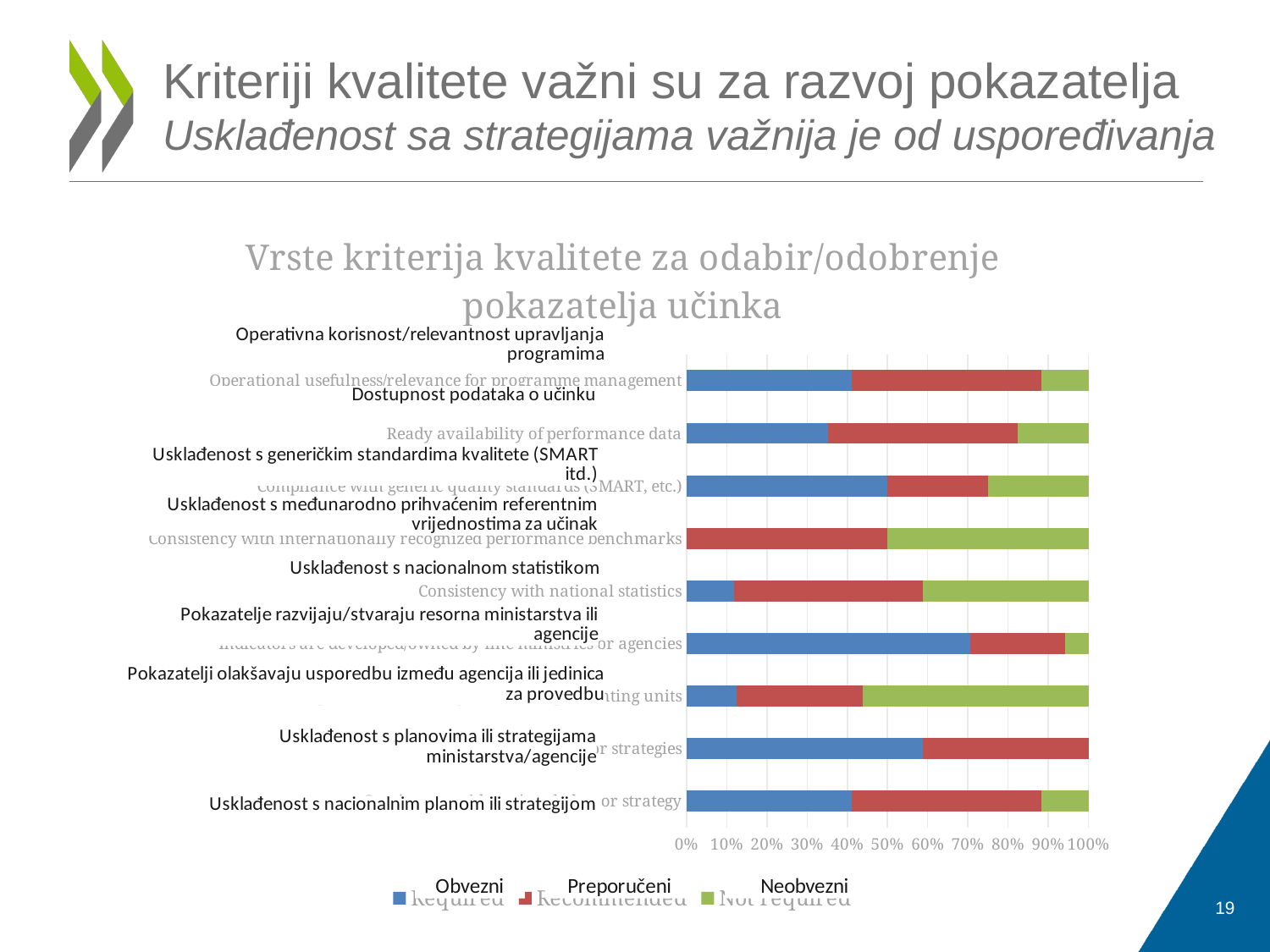
How many series does the chart legend list? 3 What kind of chart is shown on the slide? Stacked bar chart Is the Obvezni share for 'Usklađenost s planovima ili strategijama ministarstva/agencije' greater or less than 50%? greater Which series is shown in blue in the chart? Obvezni Which category has the largest Obvezni (blue) share? Pokazatelje razvijaju/stvaraju resorna ministarstva ili agencije Which category has no Neobvezni (green) segment at all? Usklađenost s planovima ili strategijama ministarstva/agencije How many categories (criteria) are plotted in the chart? 9 Which category has no Obvezni (blue) segment at all? Usklađenost s međunarodno prihvaćenim referentnim vrijednostima za učinak What is the title of the chart? Vrste kriterija kvalitete za odabir/odobrenje pokazatelja učinka Is the Obvezni share for 'Usklađenost s nacionalnom statistikom' greater or less than 20%? less Which has a larger Obvezni share: 'Usklađenost s generičkim standardima kvalitete (SMART itd.)' or 'Usklađenost s nacionalnom statistikom'? Usklađenost s generičkim standardima kvalitete (SMART itd.) Is the Obvezni share for 'Pokazatelje razvijaju/stvaraju resorna ministarstva ili agencije' greater or less than 60%? greater